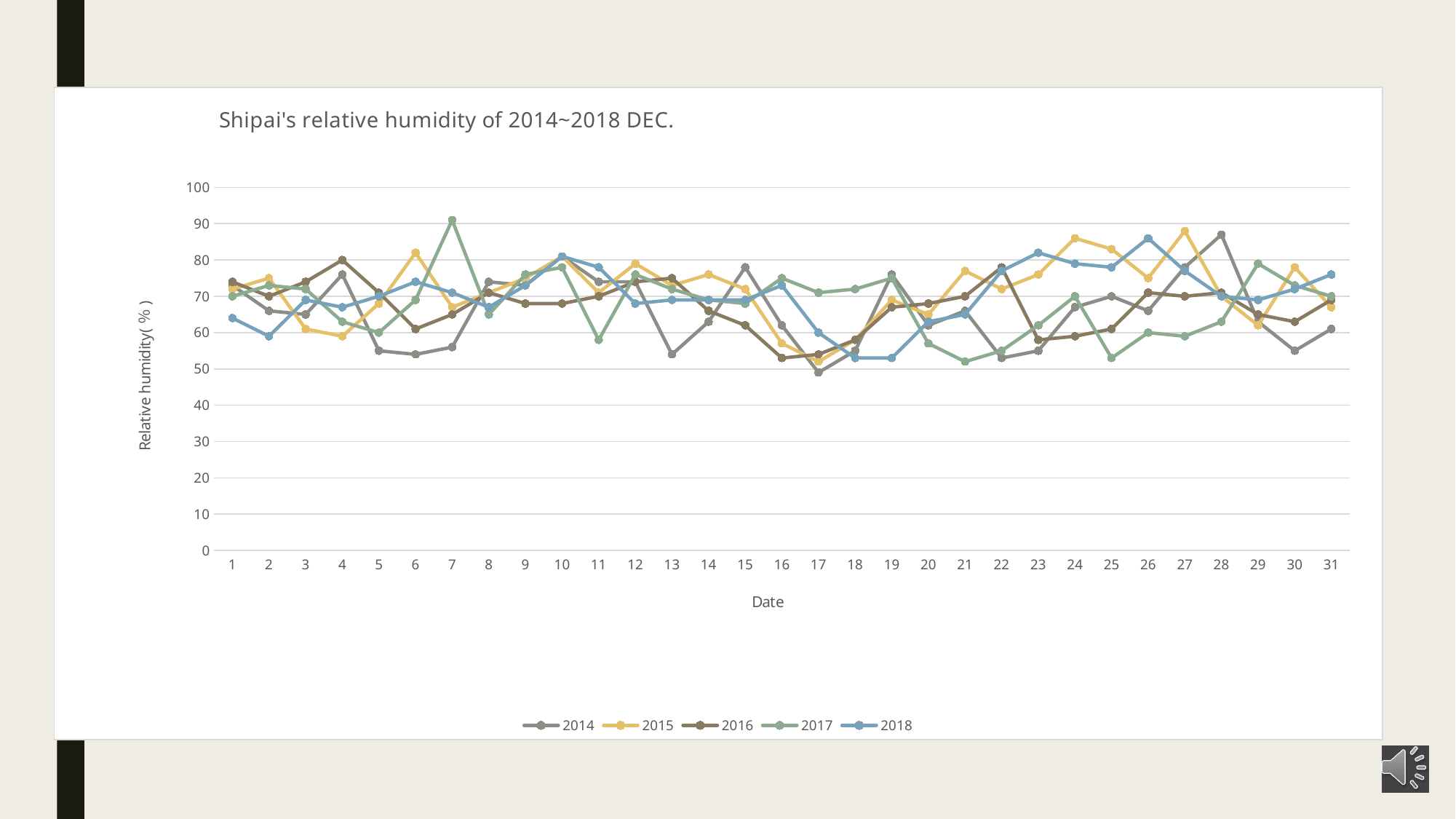
Is the value for 2014 on date 17 greater or less than 60? less Which series has the lowest value on date 2? 2018 Is the value for 2018 on date 2 greater or less than 70? less What kind of chart is shown on the slide? line chart How many dates are plotted along the x axis? 31 What is the title of the chart? Shipai's relative humidity of 2014~2018 DEC. How many series does the legend list? 5 Is the value for 2017 on date 7 greater or less than 80? greater Which series has the highest value on date 7? 2017 What is the label of the vertical axis? Relative humidity( % ) On date 24, which is higher, the value for 2015 or the value for 2016? 2015